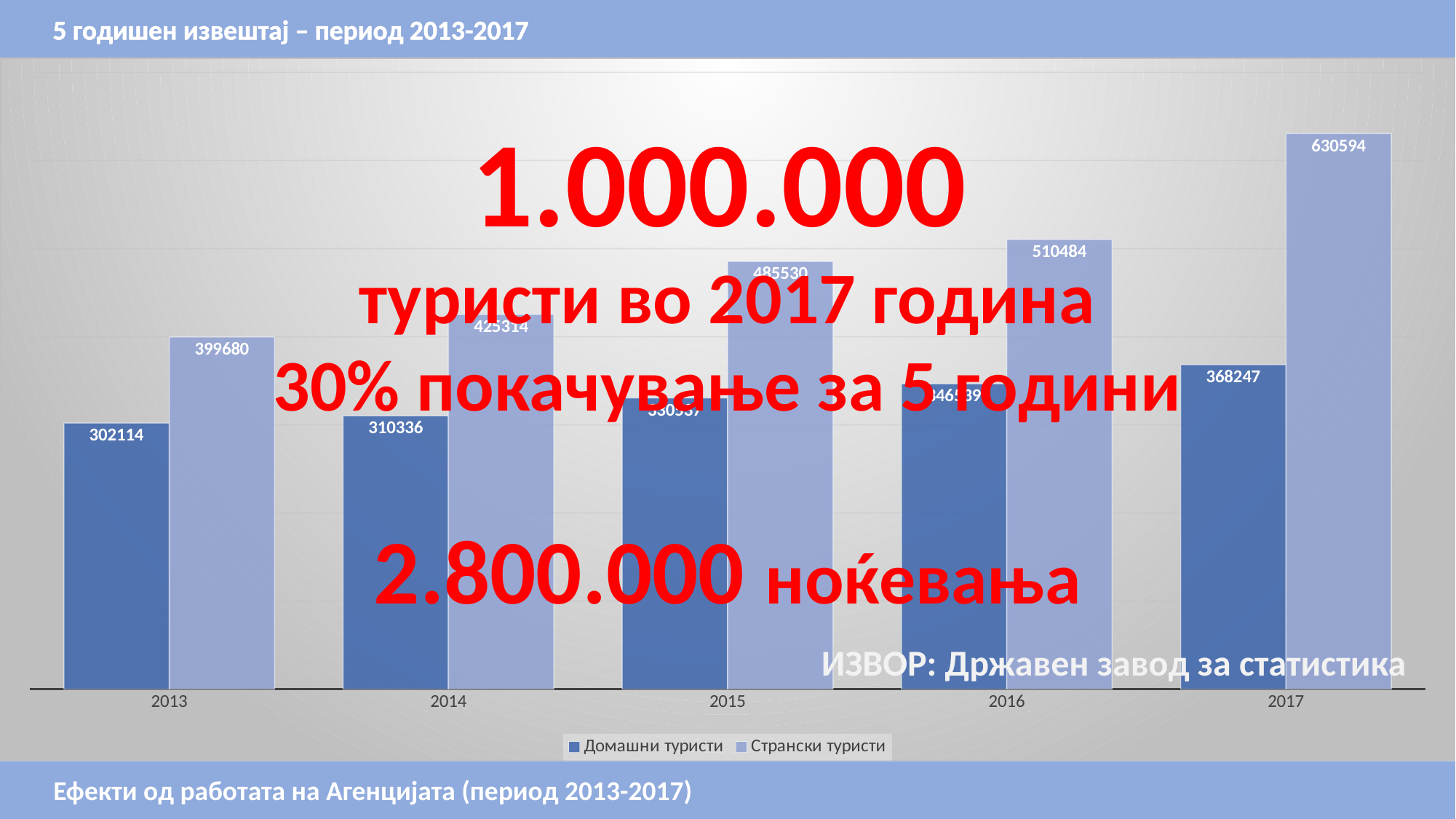
What is the value for Странски туристи in 2013? 399680 What is the value for Домашни туристи in 2017? 368247 How many series does the legend list? 2 In which year is the value for Странски туристи the highest? 2017 Do the values for Странски туристи rise or fall from 2013 to 2017? rise What is the value for Странски туристи in 2016? 510484 What is the value for Странски туристи in 2017? 630594 In which year is the value for Домашни туристи the lowest? 2013 What is the difference between Странски туристи and Домашни туристи in 2017? 262347 What is the value for Домашни туристи in 2013? 302114 How many years are shown on the x axis of the chart? 5 In 2013, which series has the larger value, Домашни туристи or Странски туристи? Странски туристи